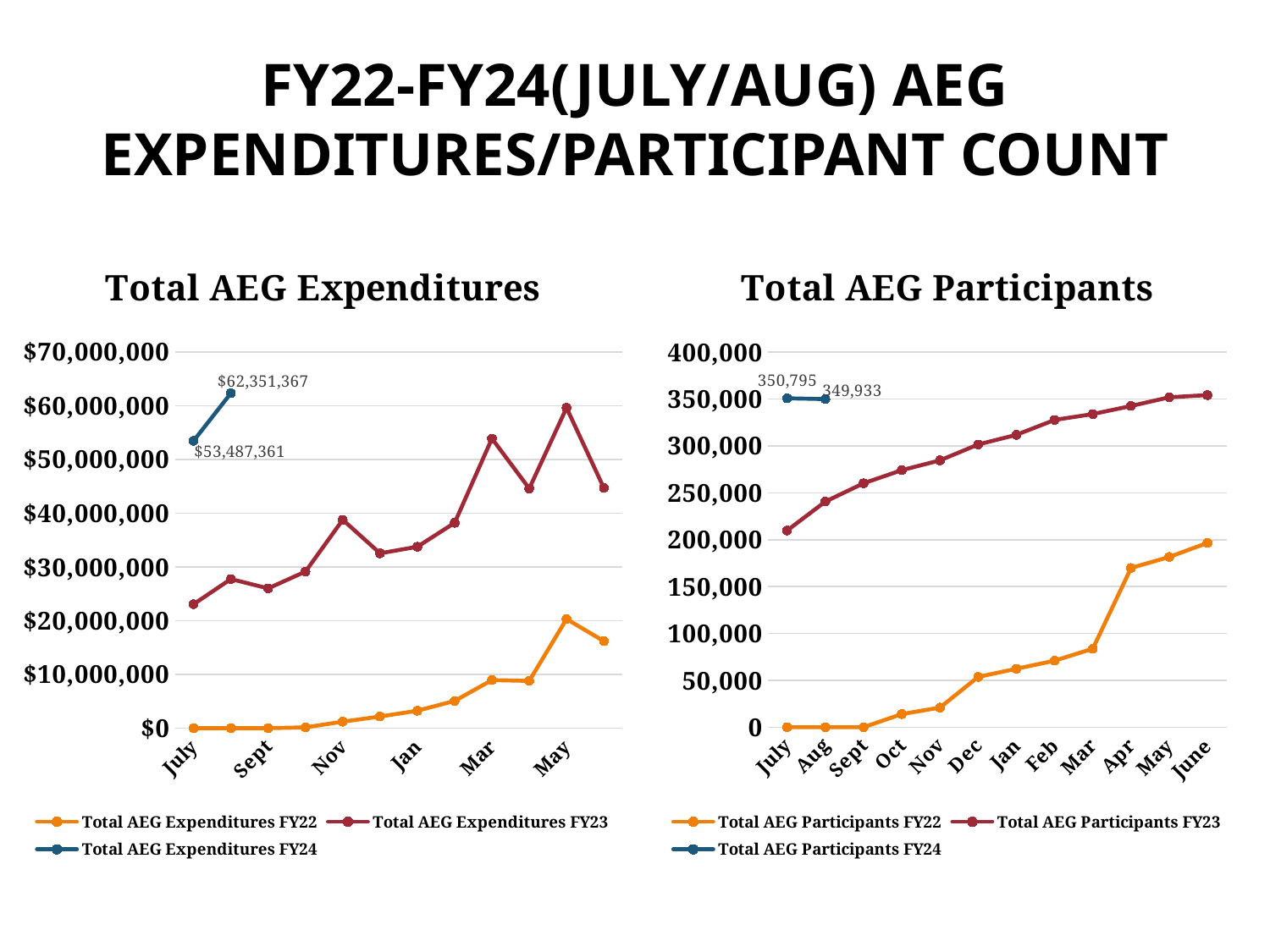
In the Total AEG Expenditures chart, by how much did FY24 expenditures increase from July to Aug? $8,864,006 In the Total AEG Participants chart, what is the FY24 participant count labelled for Aug? 349,933 In the Total AEG Expenditures chart, what is the FY24 expenditure value labelled for Aug? $62,351,367 How many series does the legend of the Total AEG Expenditures chart list? 3 In the Total AEG Participants chart, what is the difference between the FY24 July and Aug participant counts? 862 In the Total AEG Participants chart, do the FY23 participant values rise or fall from July to June? rise What kind of chart is the Total AEG Participants chart? Line chart In the Total AEG Expenditures chart, is the FY23 expenditure for May greater or less than $50,000,000? greater In the Total AEG Participants chart, what is the FY24 participant count labelled for July? 350,795 In the Total AEG Participants chart, which FY24 month has the larger participant count, July or Aug? July In the Total AEG Participants chart, is the FY22 participant count for June greater or less than 150,000? greater In the Total AEG Expenditures chart, what is the FY24 expenditure value labelled for July? $53,487,361